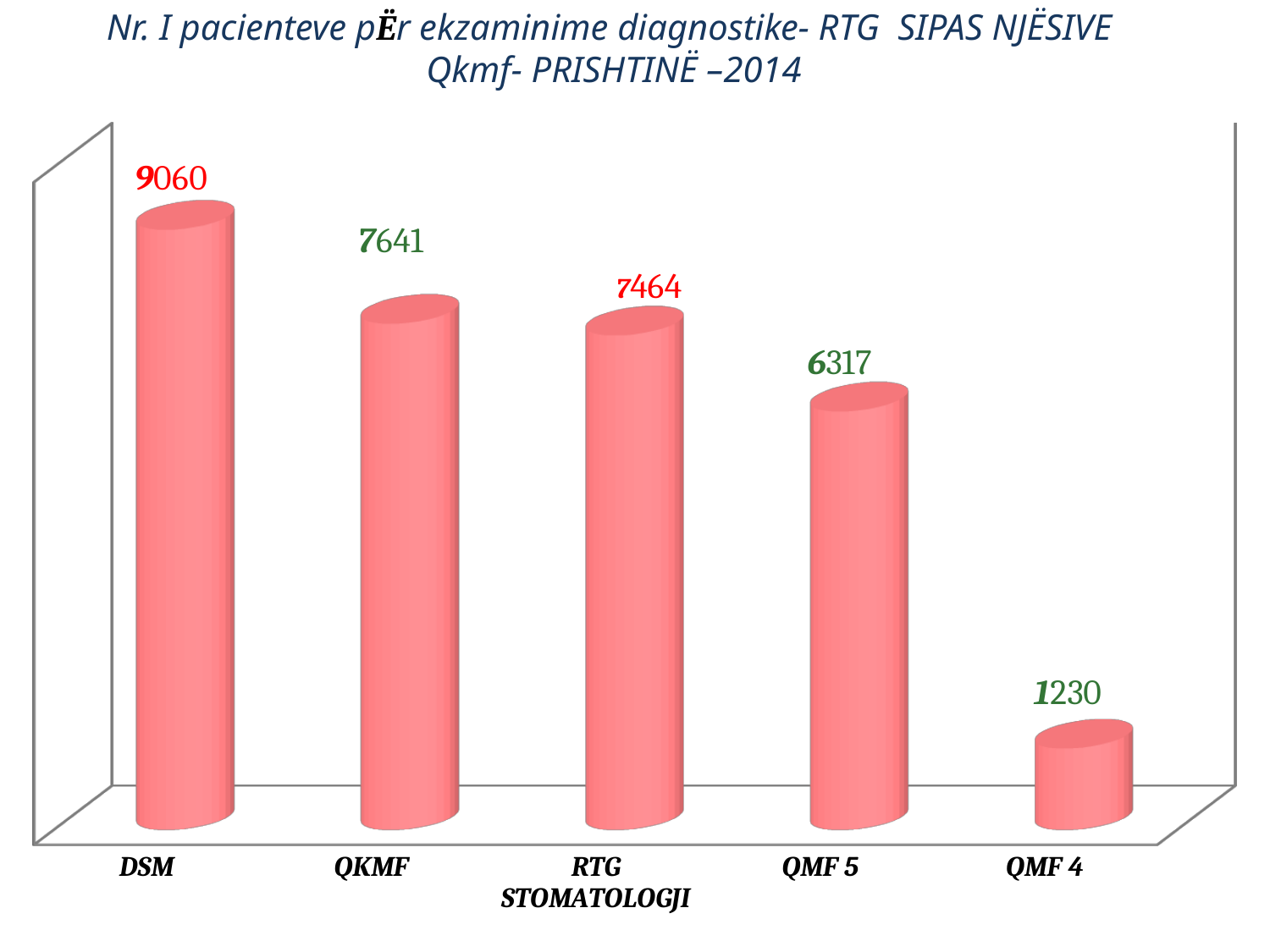
What is the value for DSM? 9060 What is the value for QMF 4? 1230 What is the value for RTG STOMATOLOGJI? 7464 What kind of chart is shown on the slide? Bar chart Which category has the lowest value? QMF 4 What is the value for QKMF? 7641 Which is larger, the value for QKMF or the value for QMF 5? QKMF Which category has the highest value? DSM What is the difference between the values for DSM and QMF 4? 7830 How many categories are shown on the chart? 5 What is the difference between the values for QKMF and RTG STOMATOLOGJI? 177 What is the value for QMF 5? 6317